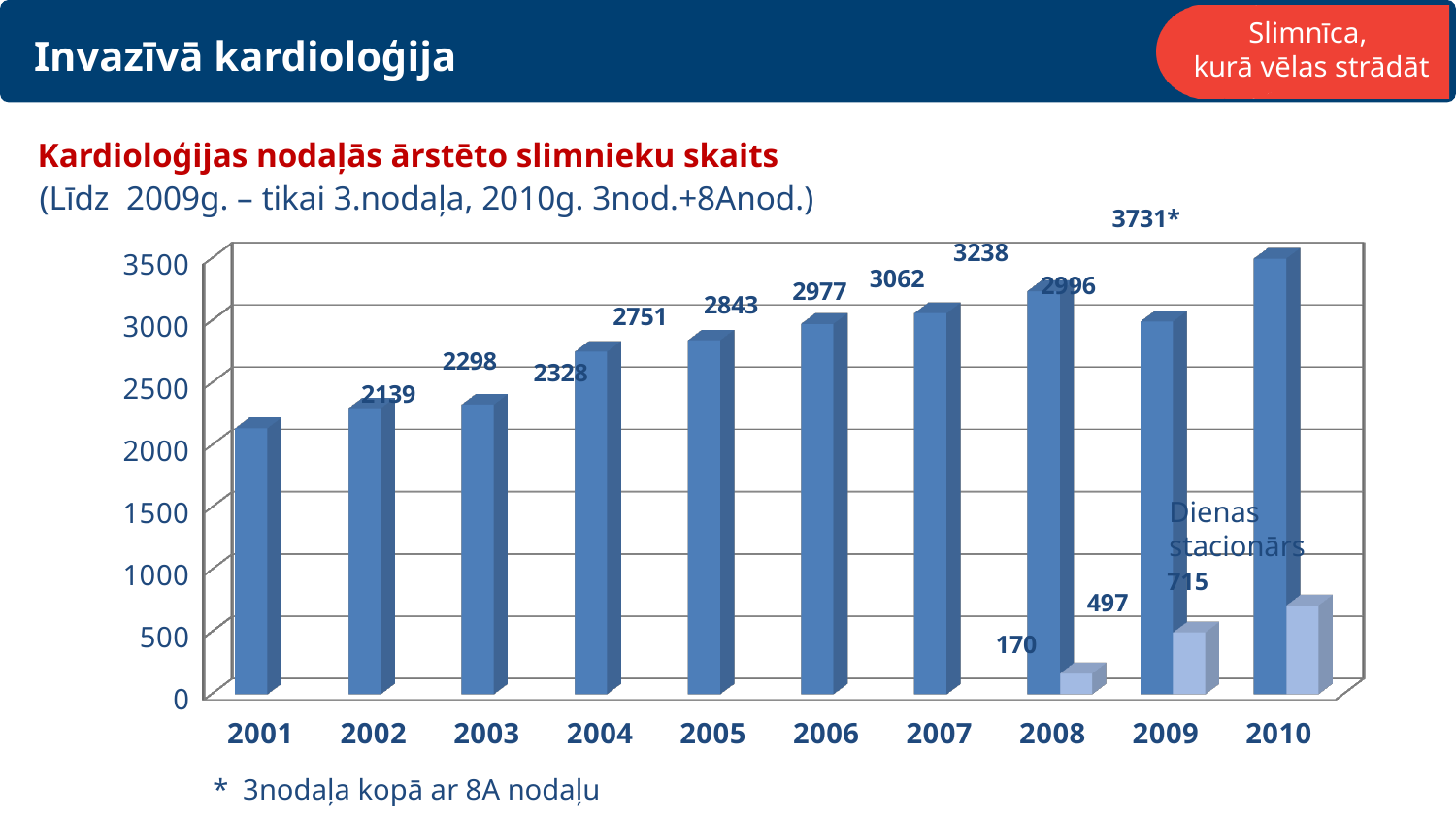
Which year has the taller dark blue bar, 2008 or 2009? 2008 Do the dark blue bars rise or fall from 2001 to 2008? rise Is the value of the dark blue bar for 2001 greater or less than 2500? less What is the Dienas stacionārs value for 2008? 170 Which year has the lowest number of treated patients (shortest dark blue bar)? 2001 What kind of chart is shown on the slide? bar chart What is the Dienas stacionārs value for 2009? 497 What is the Dienas stacionārs value for 2010? 715 How many years are shown on the x axis of the chart? 10 What data label is shown for the tallest bar, for 2010? 3731* By how much did the Dienas stacionārs value increase from 2008 to 2010? 545 Which year has the highest number of treated patients (tallest dark blue bar)? 2010